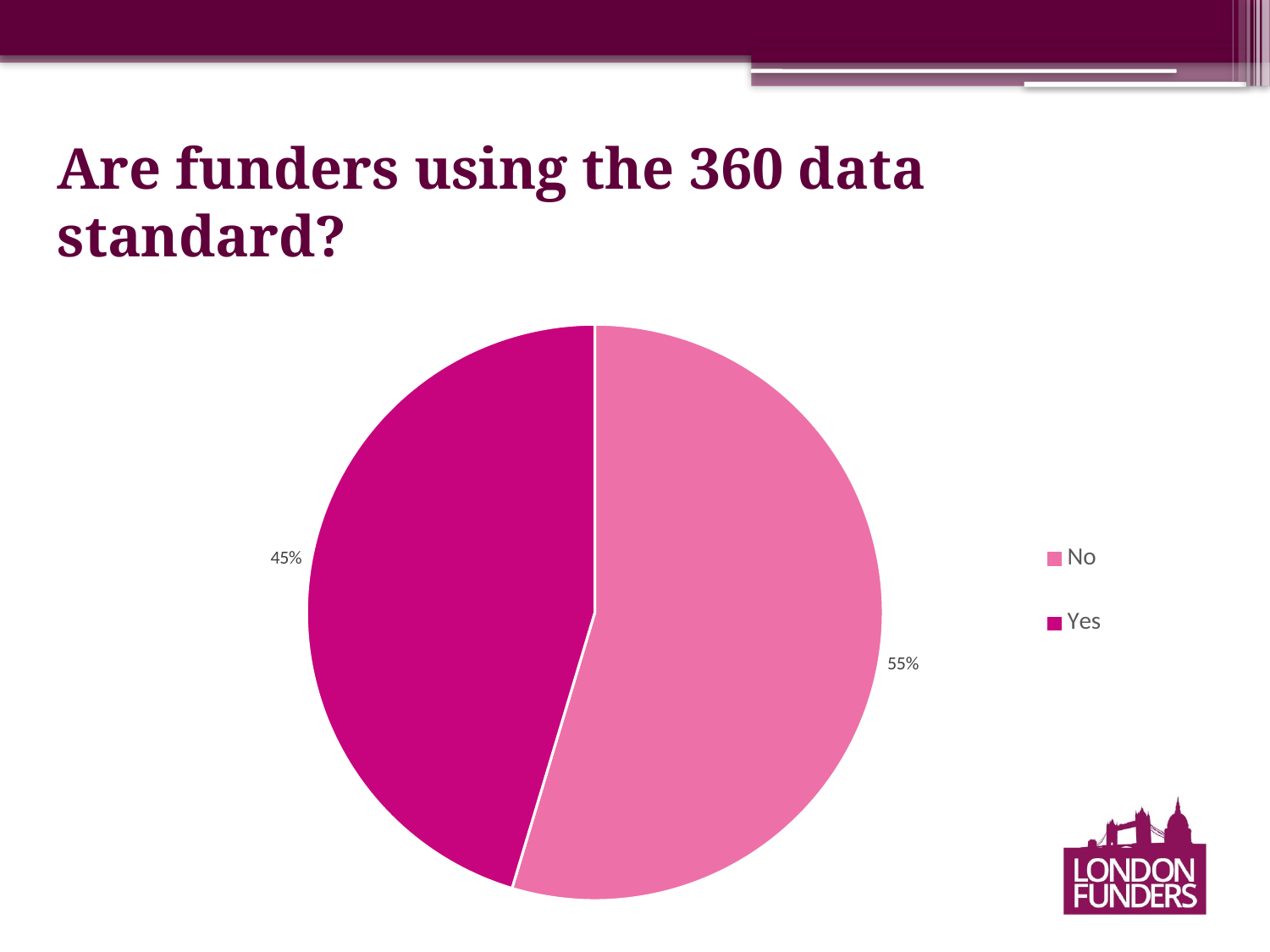
What kind of chart is shown on the slide? pie chart Is the share for "Yes" larger or smaller than the share for "No"? smaller Which response has the smaller share of the pie? Yes Which response has the larger share of the pie? No Which legend entry is shown in the darker magenta colour? Yes What percentage of funders answered "Yes"? 45% How many entries does the legend list? 2 What is the title of the slide containing the pie chart? Are funders using the 360 data standard? What percentage of funders answered "No"? 55% What is the difference in percentage points between the "No" and "Yes" slices? 10 How many slices does the pie chart have? 2 What is the share of the pie taken by the "No" slice? 55%